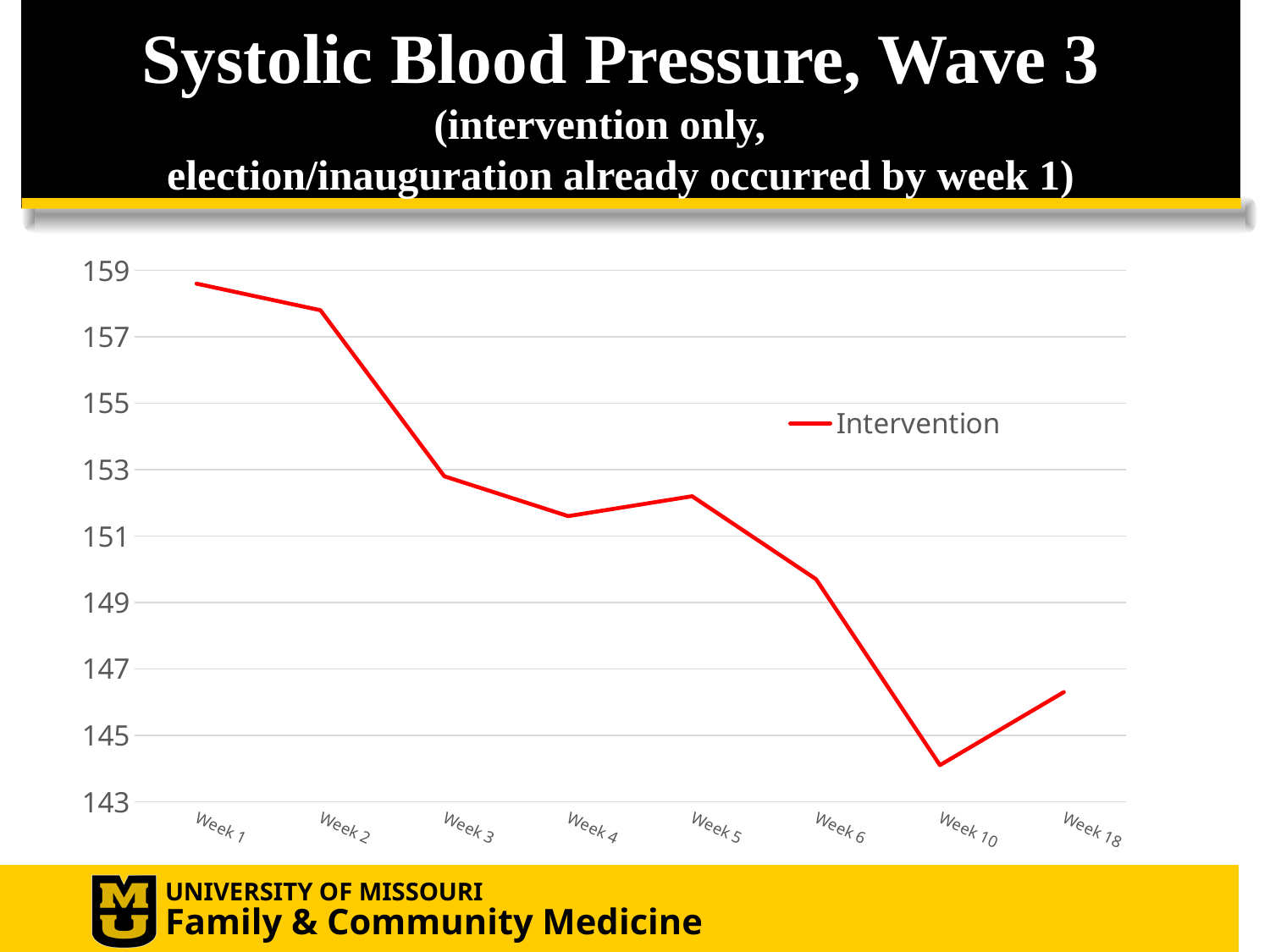
Overall, do the values rise or fall from Week 1 to Week 18? fall Which week has the highest systolic blood pressure value? Week 1 How many weeks are plotted along the x axis? 8 What is the name of the series shown in the legend? Intervention Is the value for Week 1 greater or less than 157? greater What kind of chart is shown on the slide? line chart Is the value for Week 10 greater or less than 145? less Which is larger, the value for Week 3 or the value for Week 6? Week 3 Which week has the lowest systolic blood pressure value? Week 10 How many series does the legend list? 1 Is the value for Week 3 greater or less than 155? less Which is larger, the value for Week 1 or the value for Week 10? Week 1